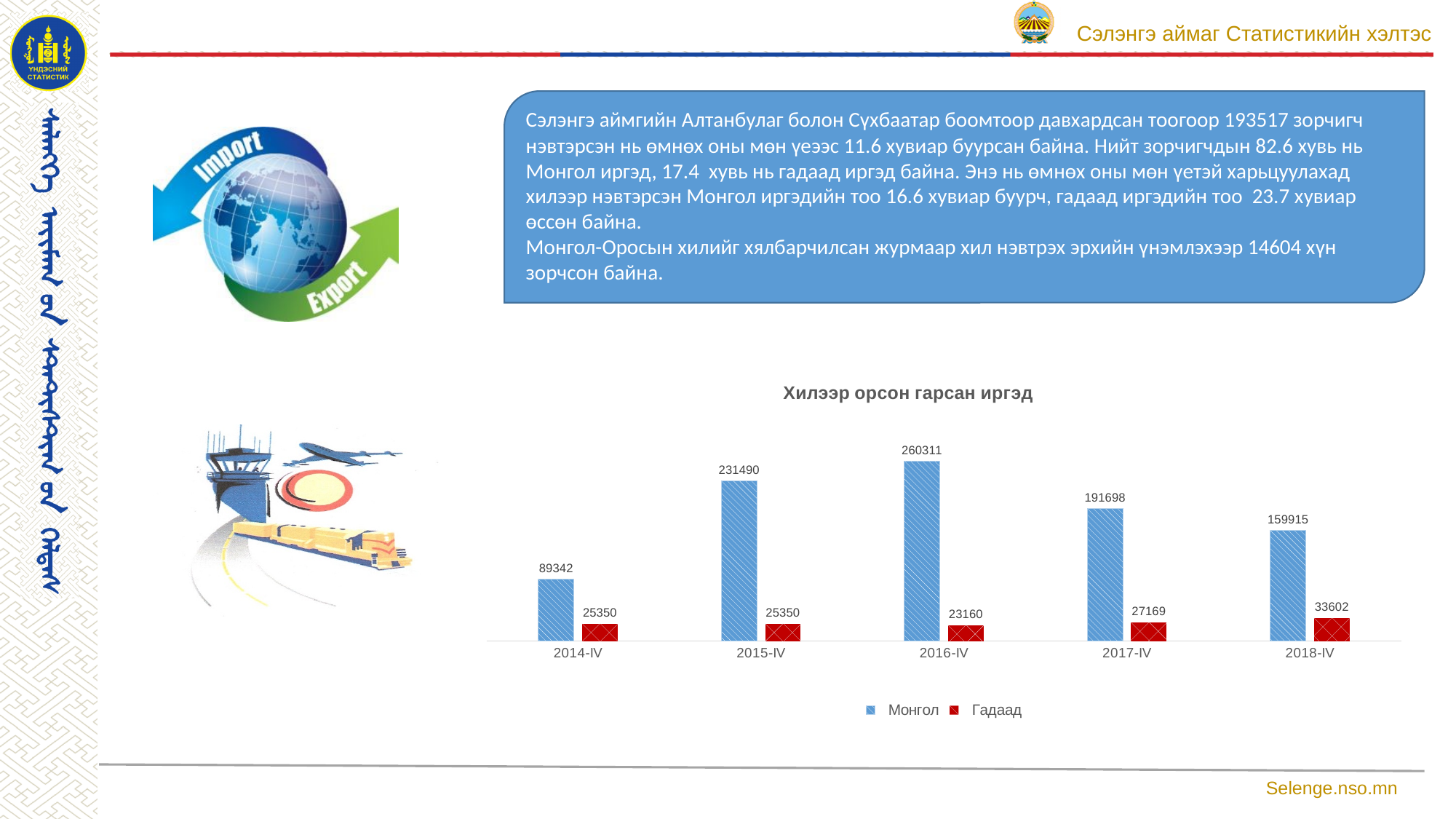
What type of chart is shown on the slide? bar chart What is the value for Монгол in 2014-IV? 89342 Which is larger, the Гадаад value in 2017-IV or in 2018-IV? 2018-IV What is the difference between the Монгол values in 2017-IV and 2018-IV? 31783 How many categories are shown on the x axis of the chart? 5 Does the Монгол value rise or fall from 2016-IV to 2018-IV? fall What is the title of the chart? Хилээр орсон гарсан иргэд In which period is the Монгол value highest? 2016-IV What is the value for Монгол in 2016-IV? 260311 In which period is the Гадаад value lowest? 2016-IV How many series does the chart legend list? 2 What is the value for Гадаад in 2018-IV? 33602